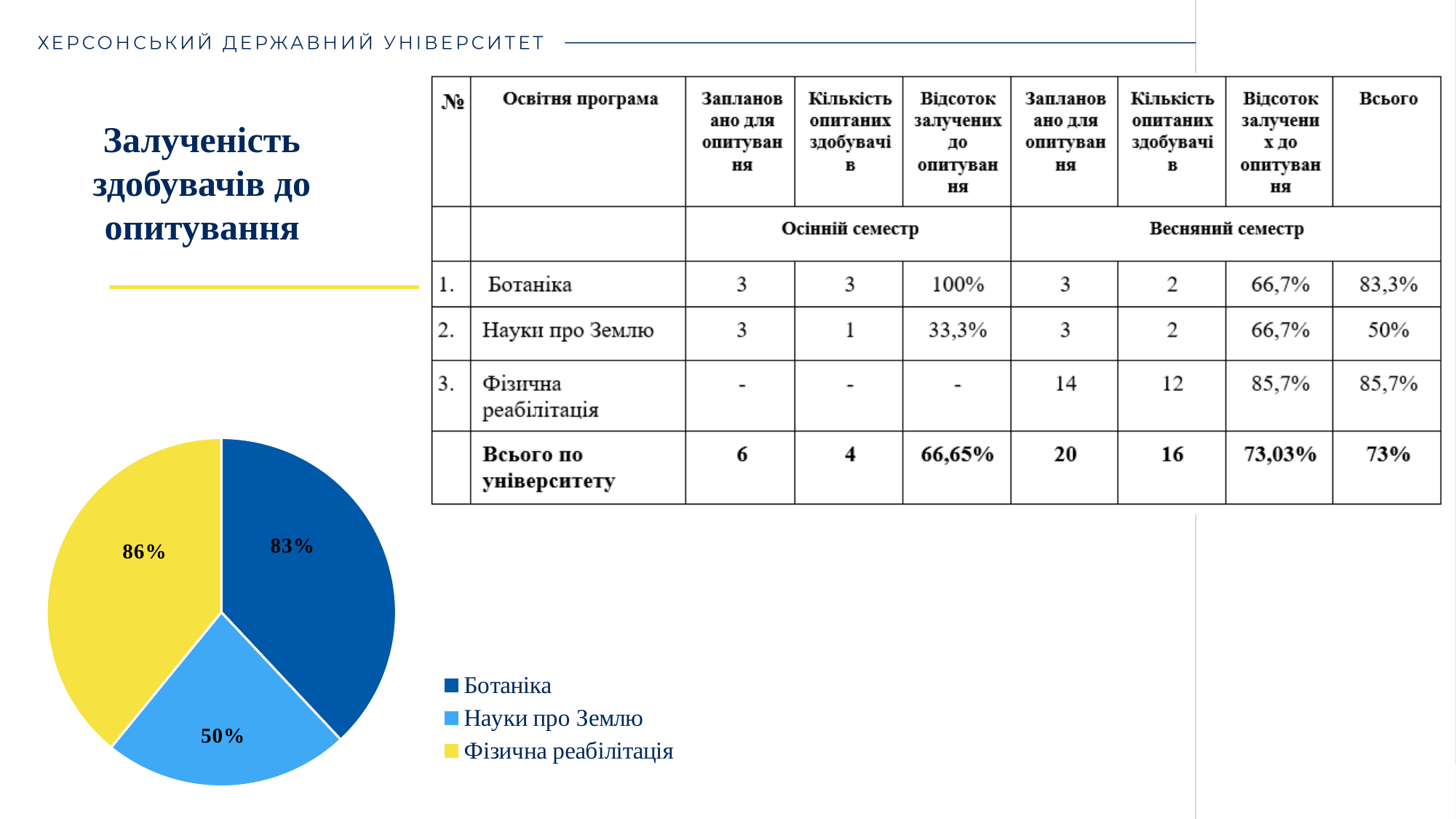
What is the difference between the values for Ботаніка and Науки про Землю in the pie chart? 33% Which has a larger value in the pie chart, Ботаніка or Науки про Землю? Ботаніка What value is shown for Науки про Землю in the pie chart? 50% What value is shown for Ботаніка in the pie chart? 83% Which category has the lowest value in the pie chart? Науки про Землю Which category has the highest value in the pie chart? Фізична реабілітація What type of chart is shown on the slide? pie chart What value is shown for Фізична реабілітація in the pie chart? 86% How many slices does the pie chart have? 3 How many entries does the pie chart legend list? 3 What colour is the slice for Фізична реабілітація in the pie chart? yellow What is the difference between the values for Фізична реабілітація and Науки про Землю in the pie chart? 36%